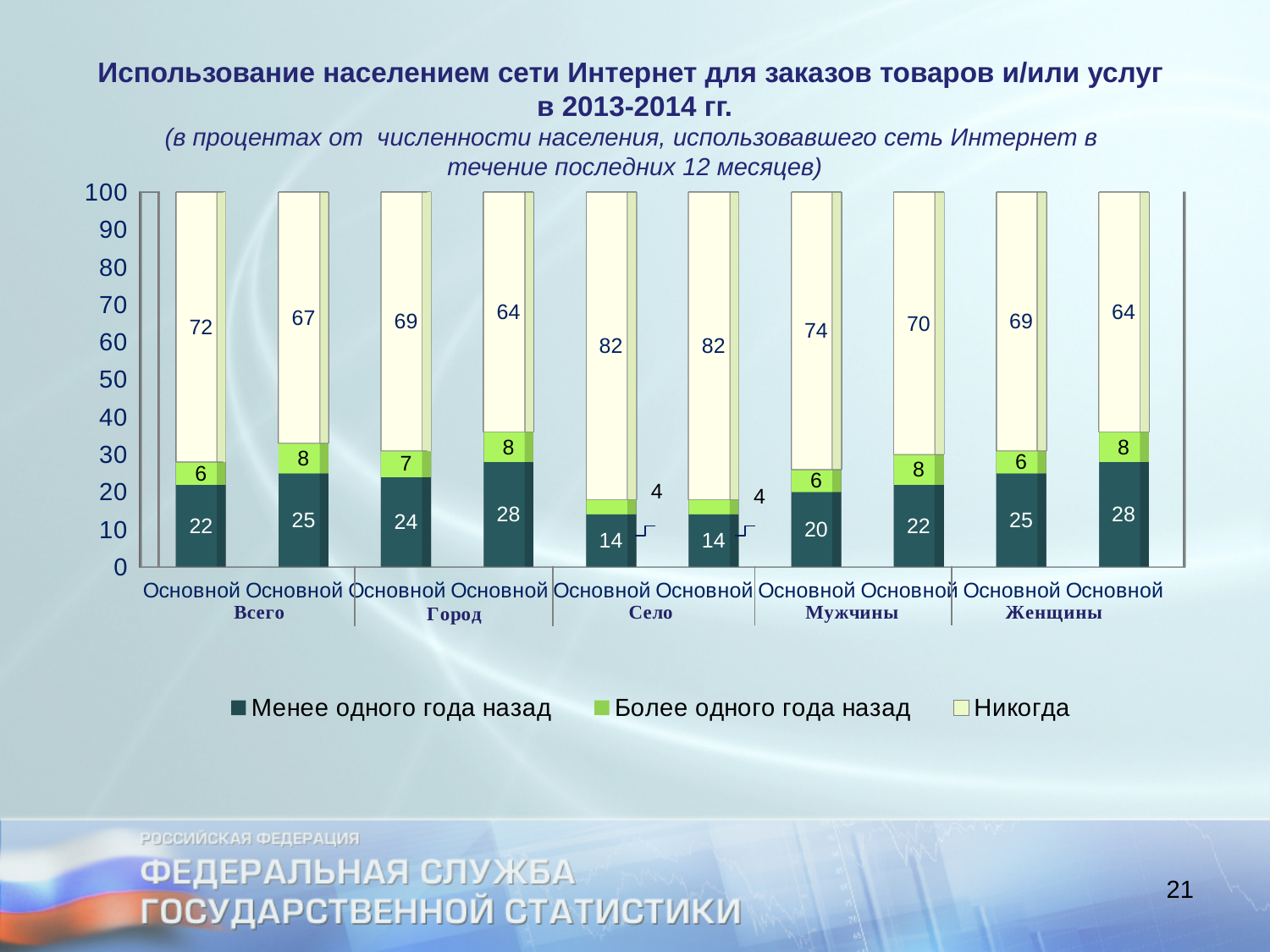
What is the total of the first stacked bar in the 'Всего' group? 100 What is the value of the 'Более одного года назад' segment in the first bar of the 'Всего' group? 6 How many labelled groups (Всего, Город, etc.) are shown on the x axis? 5 What is the value of the 'Никогда' segment in the first bar of the 'Село' group? 82 How many series does the legend list? 3 Which group has the lowest 'Менее одного года назад' value? Село What is the value of the 'Менее одного года назад' segment in the second bar of the 'Город' group? 28 Which group has the highest 'Никогда' value? Село What are the three legend entries of the chart? Менее одного года назад, Более одного года назад, Никогда Which is larger: the 'Менее одного года назад' value in the second bar of 'Мужчины' or in the second bar of 'Женщины'? Женщины What is the difference between the 'Никогда' values of the first and second bars in the 'Всего' group? 5 What kind of chart is shown on the slide? stacked bar chart